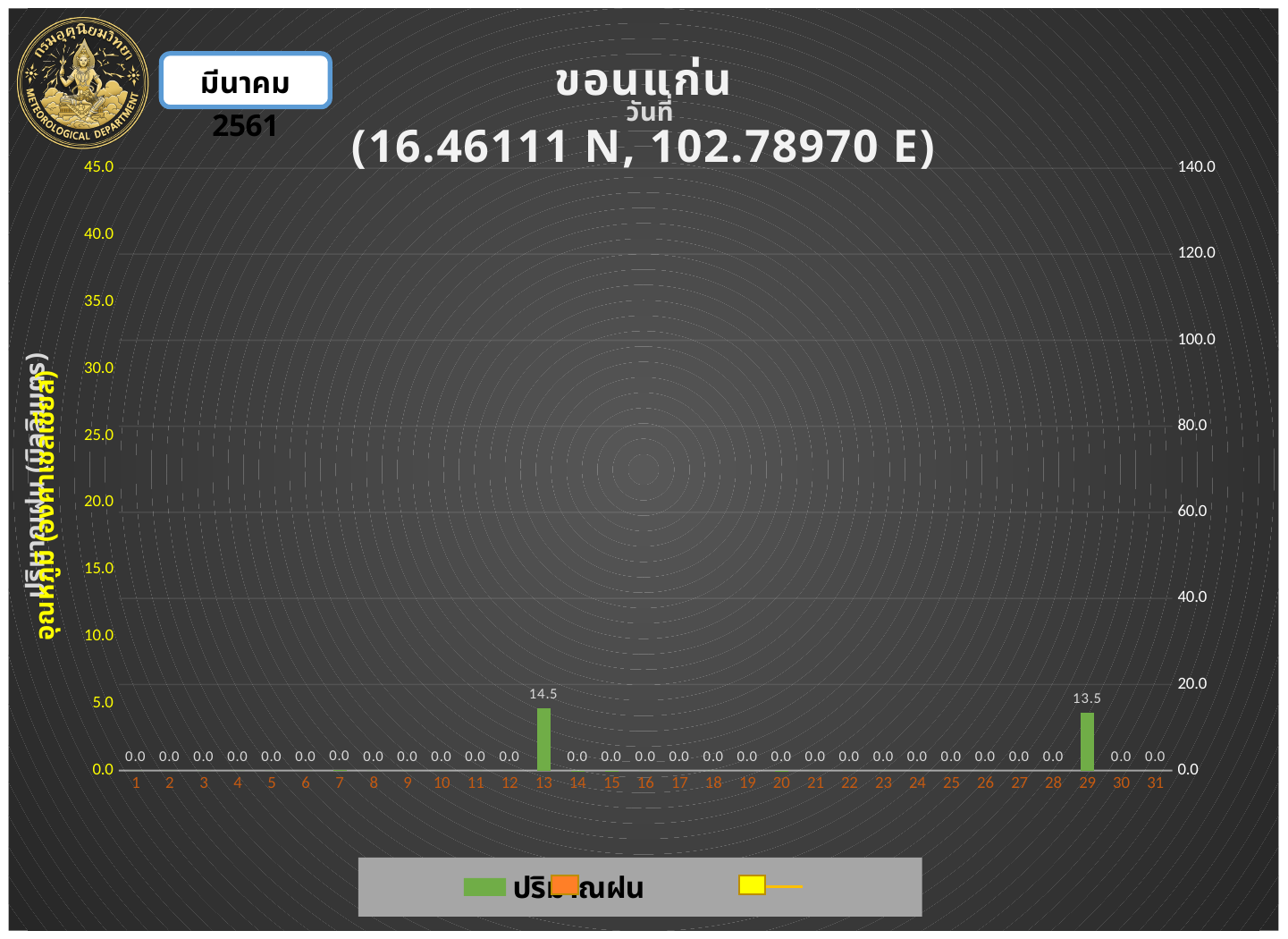
Which day has the highest rainfall value? 13 What is the rainfall value shown for day 29? 13.5 How many days are shown on the x axis? 31 What is the value shown for day 1? 0.0 What is the difference between the values for day 13 and day 29? 1.0 What kind of chart is this? Bar chart What station name is given in the chart title? ขอนแก่น What is the rainfall value shown for day 13? 14.5 Which has the larger value, day 13 or day 29? Day 13 What is the value shown for day 31? 0.0 What is the highest tick value on the right-hand axis? 140.0